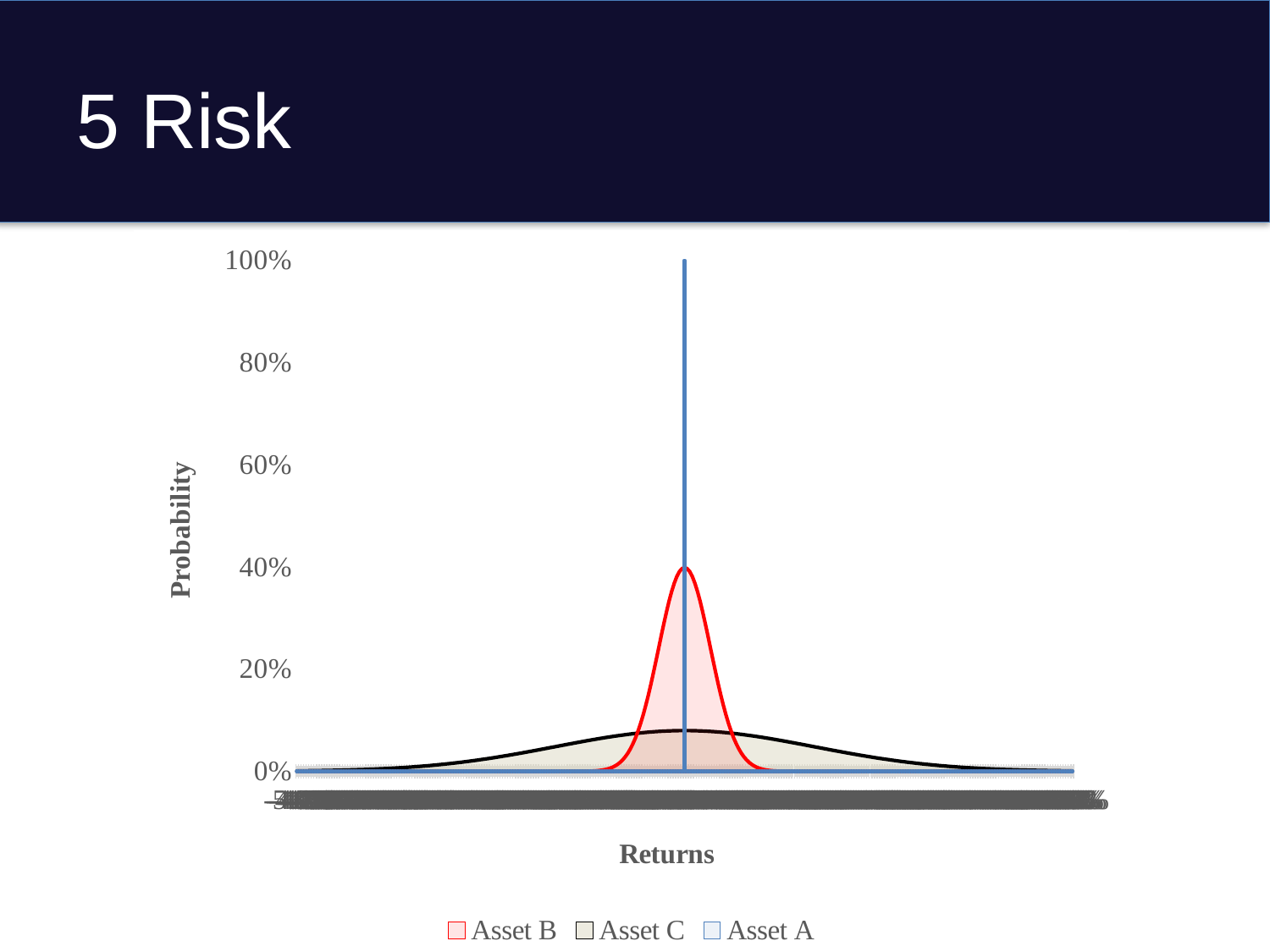
Which series has the widest spread of returns? Asset C Which series has the lowest peak probability? Asset C What are the series names listed in the legend? Asset B, Asset C, Asset A How many series does the legend list? 3 Is the peak value for Asset B greater or less than 60%? less Is the peak value for Asset B greater or less than 20%? greater Which series reaches the highest peak probability? Asset A What is the title of the vertical axis? Probability Is the peak value for Asset A greater or less than 80%? greater What is the highest tick value shown on the vertical axis? 100% Which series has a higher peak, Asset B or Asset C? Asset B